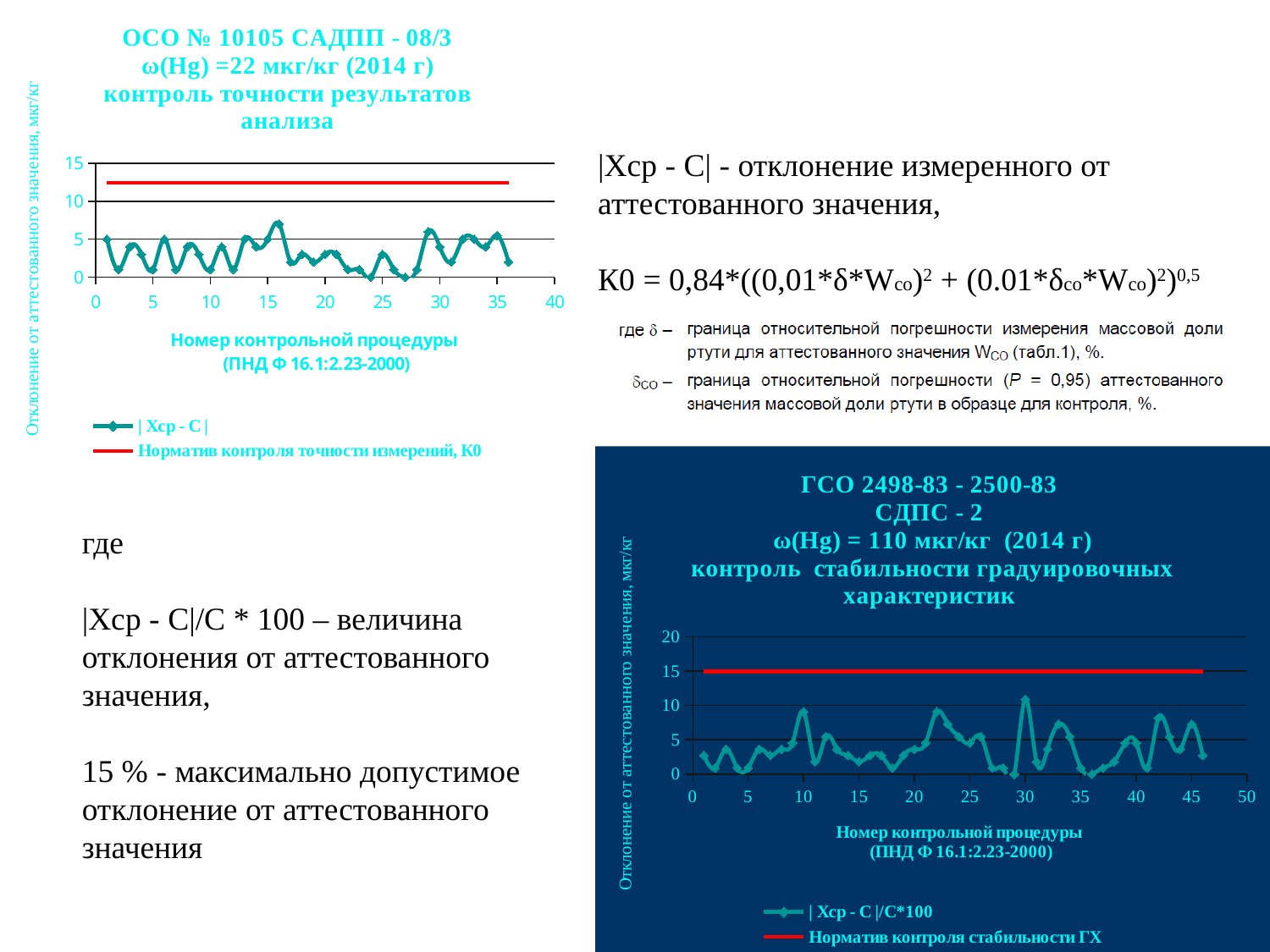
In the top-left chart, is the value of the 'Норматив контроля точности измерений, К0' line greater or less than 10? greater In the top-left chart, are all the '| Xср - С |' values greater or less than 10? less How many series does the legend of the bottom-right chart list? 2 What kind of chart is the top-left chart titled 'ОСО № 10105 САДПП - 08/3'? line chart What is the x-axis title of the bottom-right chart? Номер контрольной процедуры (ПНД Ф 16.1:2.23-2000) In the top-left chart, is the value of the 'Норматив контроля точности измерений, К0' line greater or less than 15? less In the bottom-right chart, what value does the 'Норматив контроля стабильности ГХ' line sit at on the y axis? 15 What kind of chart is the bottom-right chart titled 'ГСО 2498-83 - 2500-83 СДПС - 2'? line chart How many series does the legend of the top-left chart list? 2 In the bottom-right chart, which series is higher across the whole x axis: '| Xср - С |/С*100' or 'Норматив контроля стабильности ГХ'? Норматив контроля стабильности ГХ What colour is the 'Норматив контроля точности измерений, К0' line in the top-left chart? red